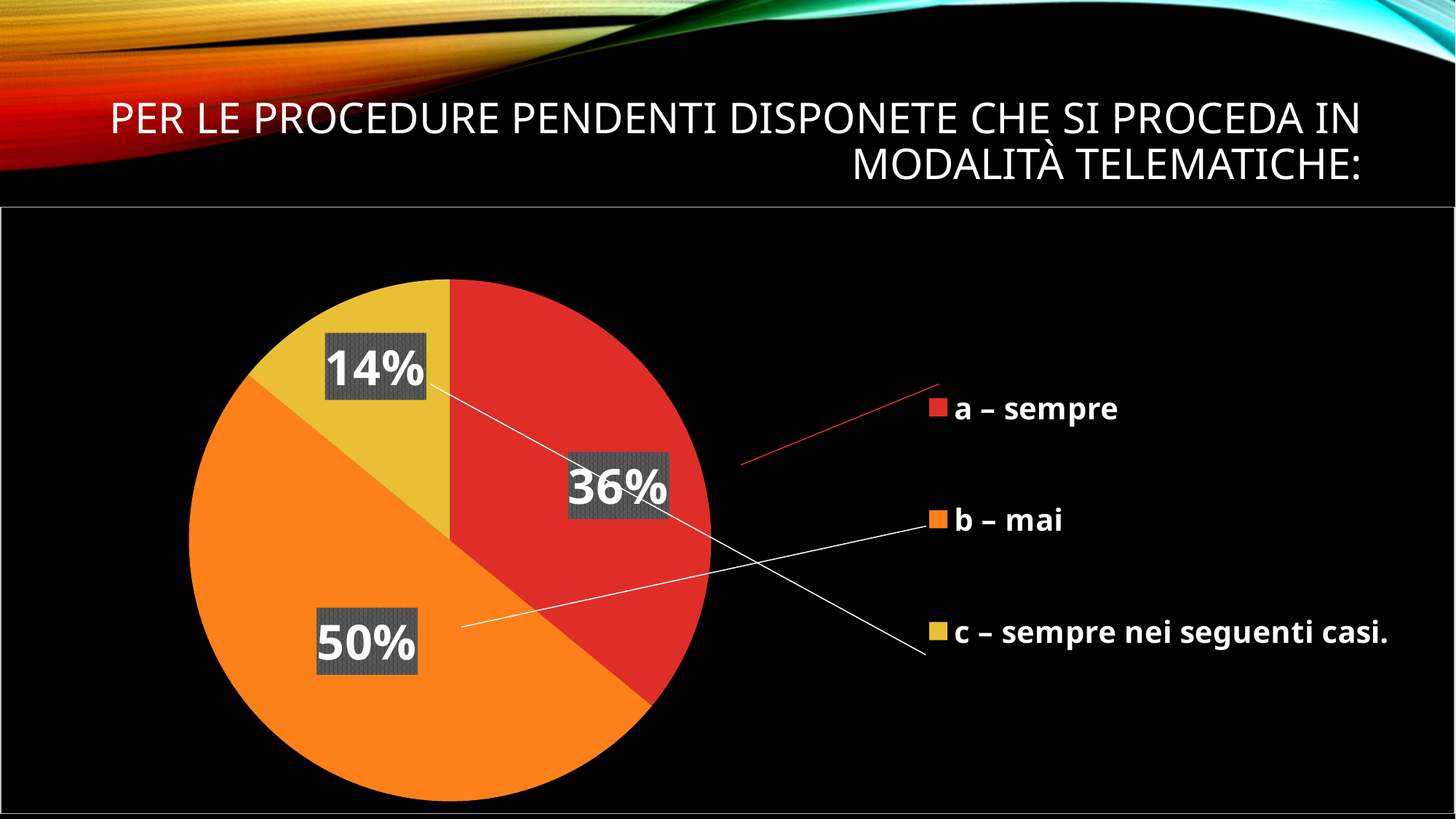
What kind of chart is shown on the slide? pie chart Which legend entry is shown in red? a – sempre What share of the pie does "b – mai" represent? 50% Which is larger, the slice for "a – sempre" or the slice for "c – sempre nei seguenti casi."? a – sempre What share of the pie does "c – sempre nei seguenti casi." represent? 14% What is the difference in percentage points between "a – sempre" and "c – sempre nei seguenti casi."? 22 What share of the pie does "a – sempre" represent? 36% What colour is the slice for "b – mai"? orange Which category has the smallest slice of the pie? c – sempre nei seguenti casi. What is the difference in percentage points between "b – mai" and "a – sempre"? 14 Which category has the largest slice of the pie? b – mai How many slices does the pie chart have? 3